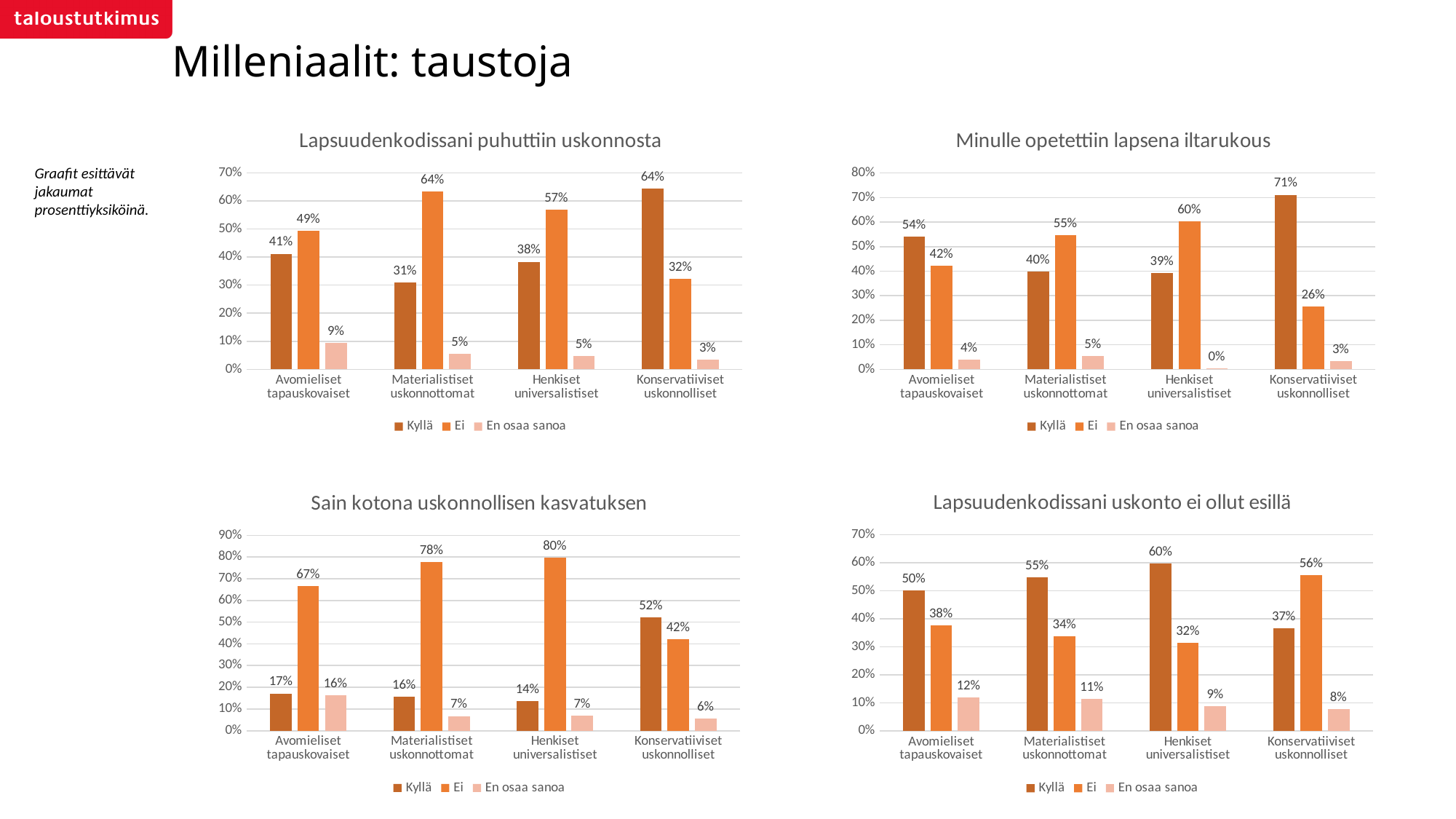
In the chart titled 'Minulle opetettiin lapsena iltarukous', what is the 'Ei' value for Henkiset universalistiset? 60% What is the title of the chart in the top-right position of the slide? Minulle opetettiin lapsena iltarukous In the chart titled 'Lapsuudenkodissani uskonto ei ollut esillä', what is the 'Ei' value for Materialistiset uskonnottomat? 34% In the chart titled 'Lapsuudenkodissani puhuttiin uskonnosta', what is the 'Kyllä' value for Konservatiiviset uskonnolliset? 64% In the chart titled 'Sain kotona uskonnollisen kasvatuksen', which is larger for Avomieliset tapauskovaiset: 'Kyllä' or 'En osaa sanoa'? Kyllä How many series does the legend list in the chart titled 'Minulle opetettiin lapsena iltarukous'? 3 What kind of chart is the chart titled 'Sain kotona uskonnollisen kasvatuksen'? Bar chart In the chart titled 'Minulle opetettiin lapsena iltarukous', what is the difference between the 'Kyllä' and 'Ei' values for Konservatiiviset uskonnolliset? 45 percentage points In the chart titled 'Lapsuudenkodissani uskonto ei ollut esillä', is the 'Kyllä' value for Henkiset universalistiset greater or less than 50%? greater How many categories are shown on the x axis of the chart titled 'Lapsuudenkodissani puhuttiin uskonnosta'? 4 In the chart titled 'Lapsuudenkodissani uskonto ei ollut esillä', which category has the lowest 'En osaa sanoa' value? Konservatiiviset uskonnolliset In the chart titled 'Sain kotona uskonnollisen kasvatuksen', which category has the highest 'Ei' value? Henkiset universalistiset